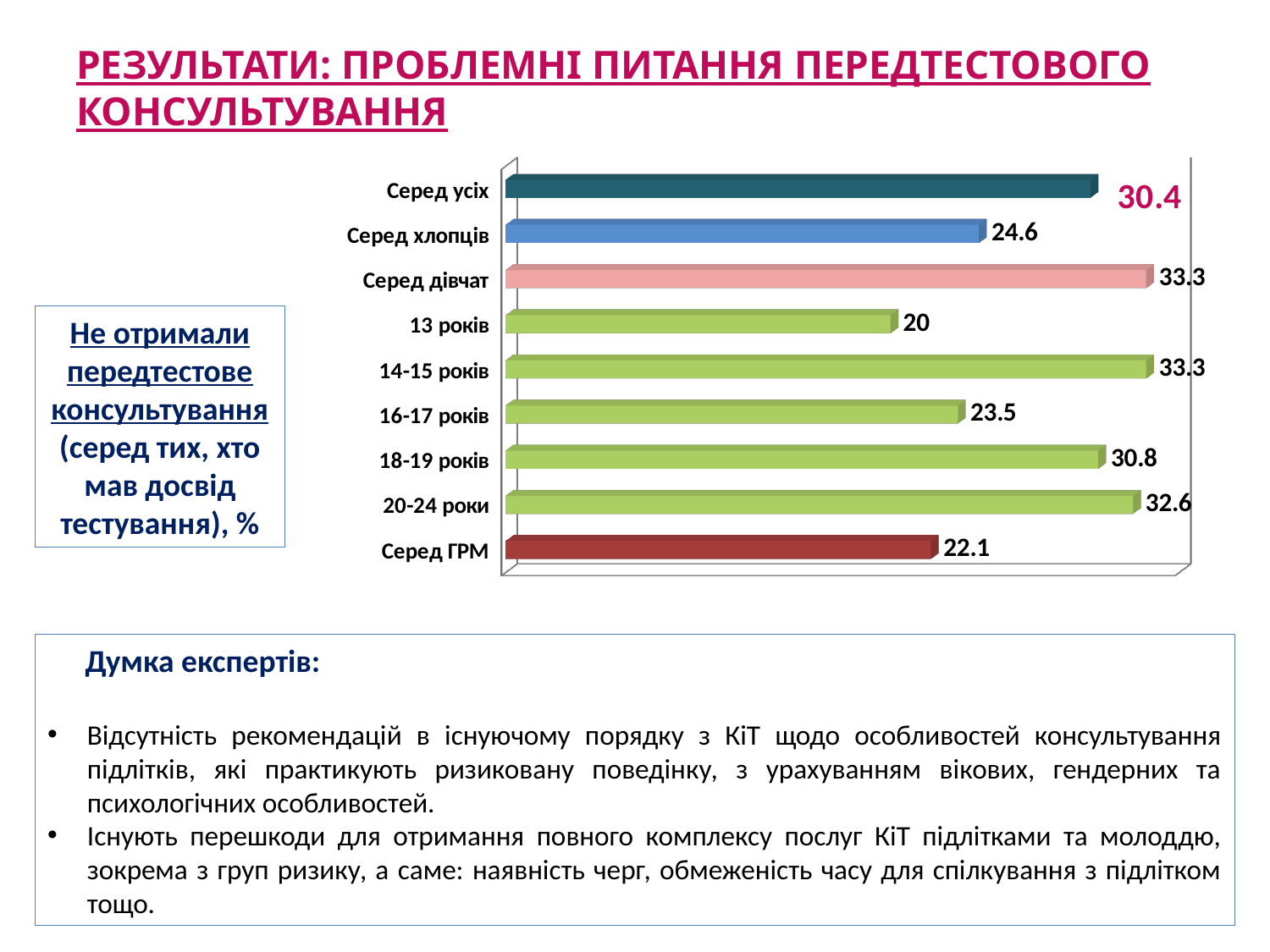
Which category has the lowest value? 13 років What is the value for "13 років"? 20 Which is larger, the value for "20-24 роки" or the value for "Серед ГРМ"? 20-24 роки What unit are the chart values expressed in, according to the text box next to the chart? % What is the value for "20-24 роки"? 32.6 What is the difference between the values for "18-19 років" and "16-17 років"? 7.3 What is the difference between the values for "Серед дівчат" and "Серед хлопців"? 8.7 What is the value for "Серед ГРМ"? 22.1 How many categories are shown in the chart? 9 What kind of chart is shown on the slide? Bar chart What is the value for "Серед усіх"? 30.4 What is the value for "Серед хлопців"? 24.6